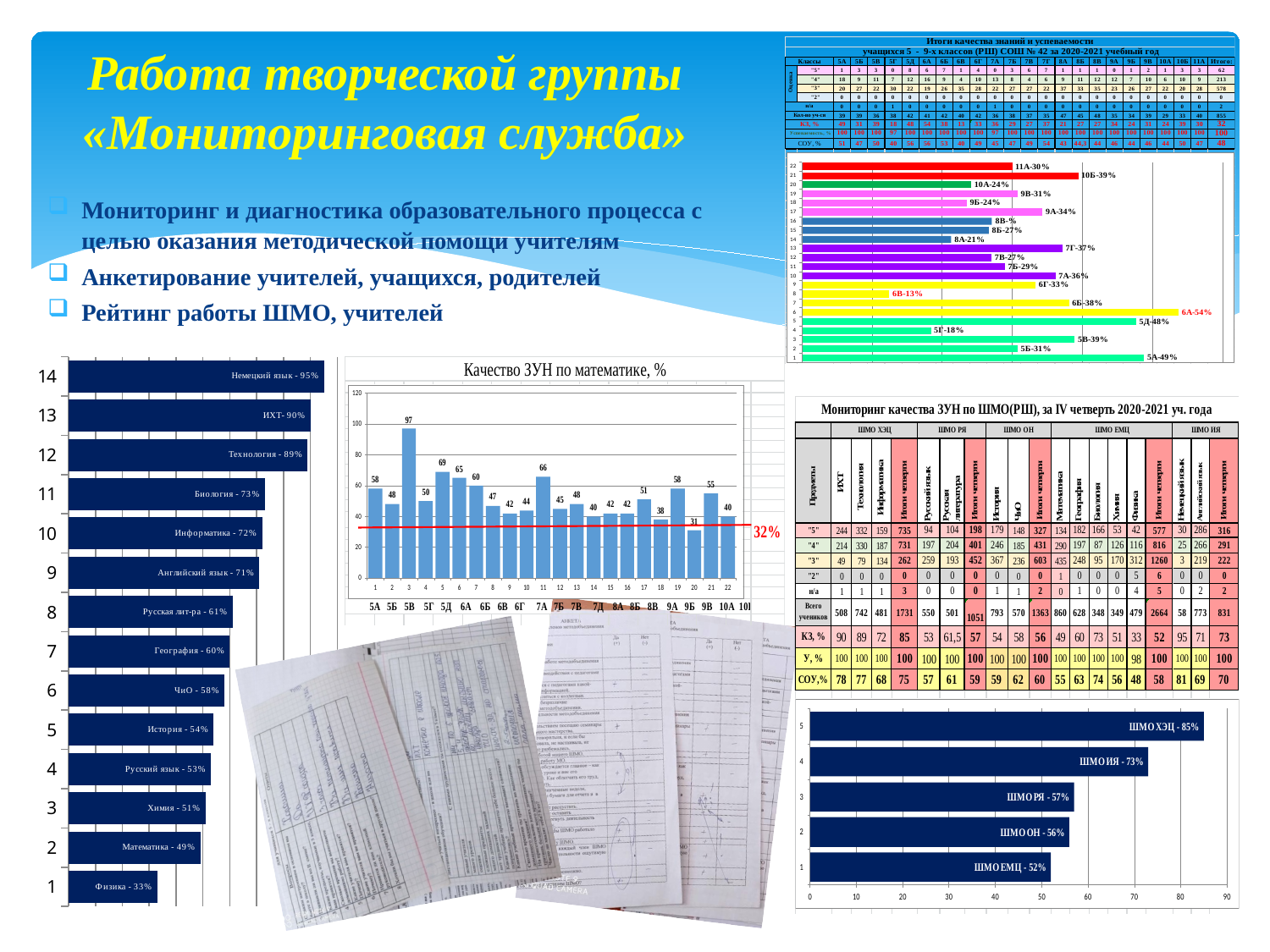
In the bottom-right horizontal bar chart of ШМО, what is the value for ШМО ЕМЦ? 52% In the bottom-left horizontal bar chart of subjects, which subject has the lowest value? Физика In the bottom-left horizontal bar chart of subjects, what is the difference between Биология and Математика? 24% What kind of chart is 'Качество ЗУН по математике, %'? bar chart In the chart titled 'Качество ЗУН по математике, %', what is the value of bar 3? 97 In the bottom-right horizontal bar chart of ШМО, what is the difference between ШМО ХЭЦ and ШМО ИЯ? 12% In the top-right horizontal bar chart of classes, which class has the lowest value? 6В In the top-right horizontal bar chart of classes, what is the value for 6А? 54% In the chart titled 'Качество ЗУН по математике, %', which numbered bar is the lowest? 20 In the chart titled 'Качество ЗУН по математике, %', which is larger: bar 5 or bar 11? bar 5 How many bars are in the bottom-left horizontal bar chart of subjects? 14 In the bottom-left horizontal bar chart of subjects, what is the value for Немецкий язык? 95%